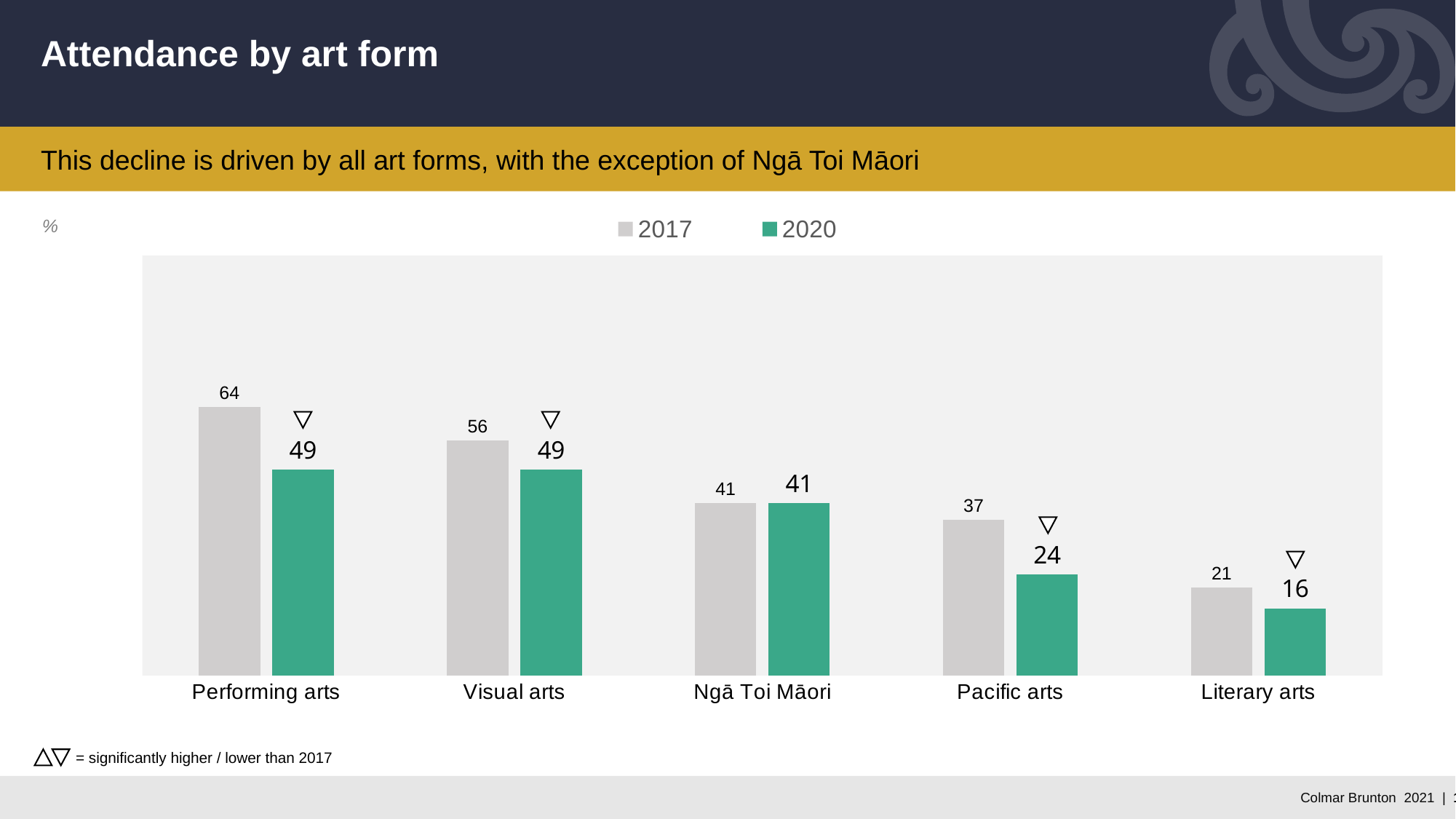
Which art form has the lowest 2020 value? Literary arts What is the difference between the 2017 and 2020 values for Pacific arts? 13 What is the 2020 value for Literary arts? 16 Which art form has the highest 2017 value? Performing arts Which art form has the same value in 2017 and 2020? Ngā Toi Māori What is the difference between the 2017 and 2020 values for Performing arts? 15 What is the 2017 value for Performing arts? 64 How many art form categories are shown on the chart? 5 Which is larger for Visual arts, the 2017 value or the 2020 value? 2017 How many series does the legend list? 2 What kind of chart is shown on the slide? Bar chart What is the 2020 value for Pacific arts? 24